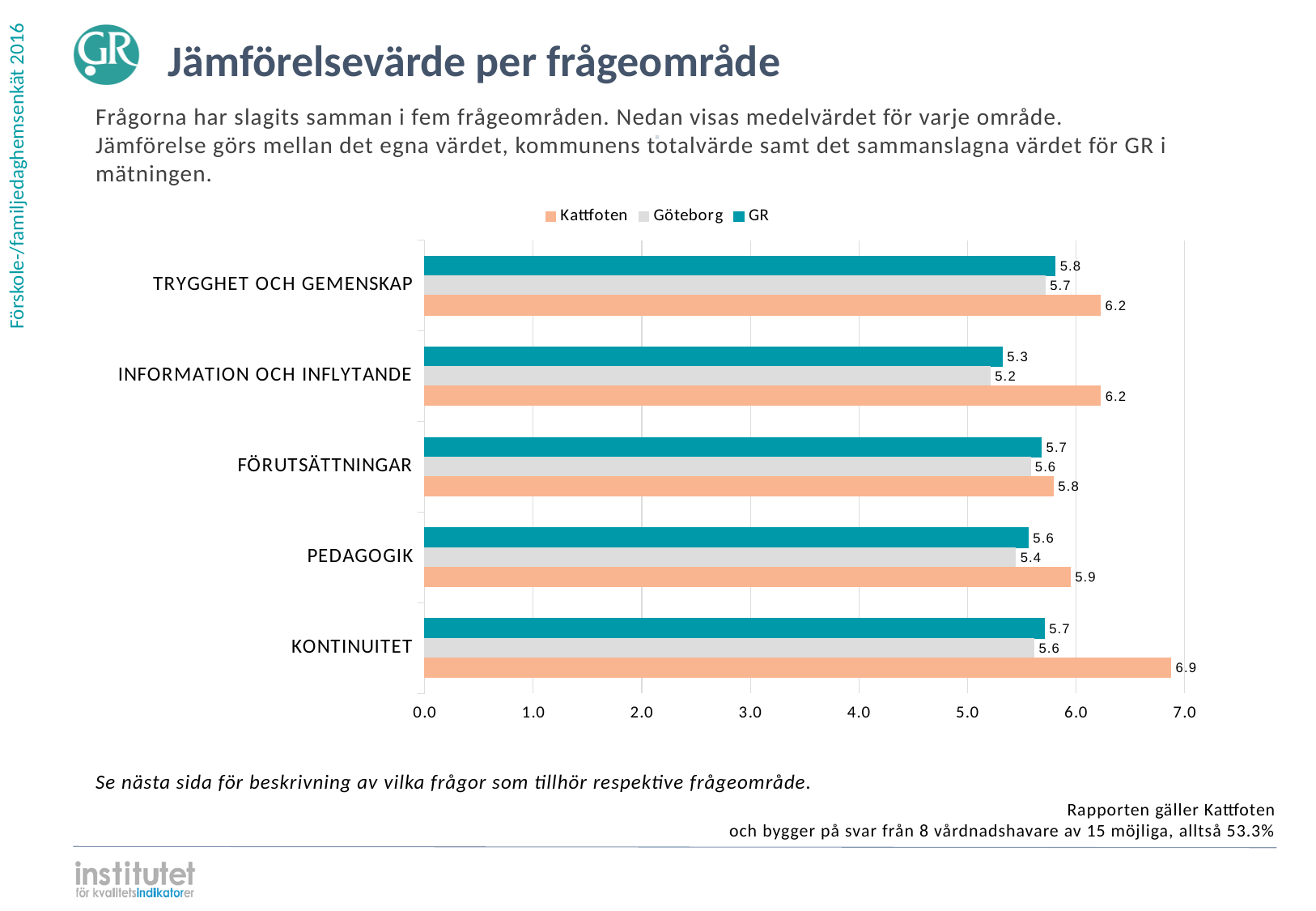
Is the Kattfoten value for PEDAGOGIK greater or less than 6.0? less What is the difference between the Kattfoten and Göteborg values for INFORMATION OCH INFLYTANDE? 1.0 Which category has the lowest Göteborg value? INFORMATION OCH INFLYTANDE Which is larger for FÖRUTSÄTTNINGAR, the Kattfoten value or the GR value? Kattfoten How many series does the legend list? 3 How many categories (frågeområden) are shown on the chart? 5 What is the GR value for PEDAGOGIK? 5.6 What is the Kattfoten value for KONTINUITET? 6.9 What is the Göteborg value for INFORMATION OCH INFLYTANDE? 5.2 Which category has the highest Kattfoten value? KONTINUITET Which series is shown in orange in the legend? Kattfoten What kind of chart is shown on the slide? bar chart